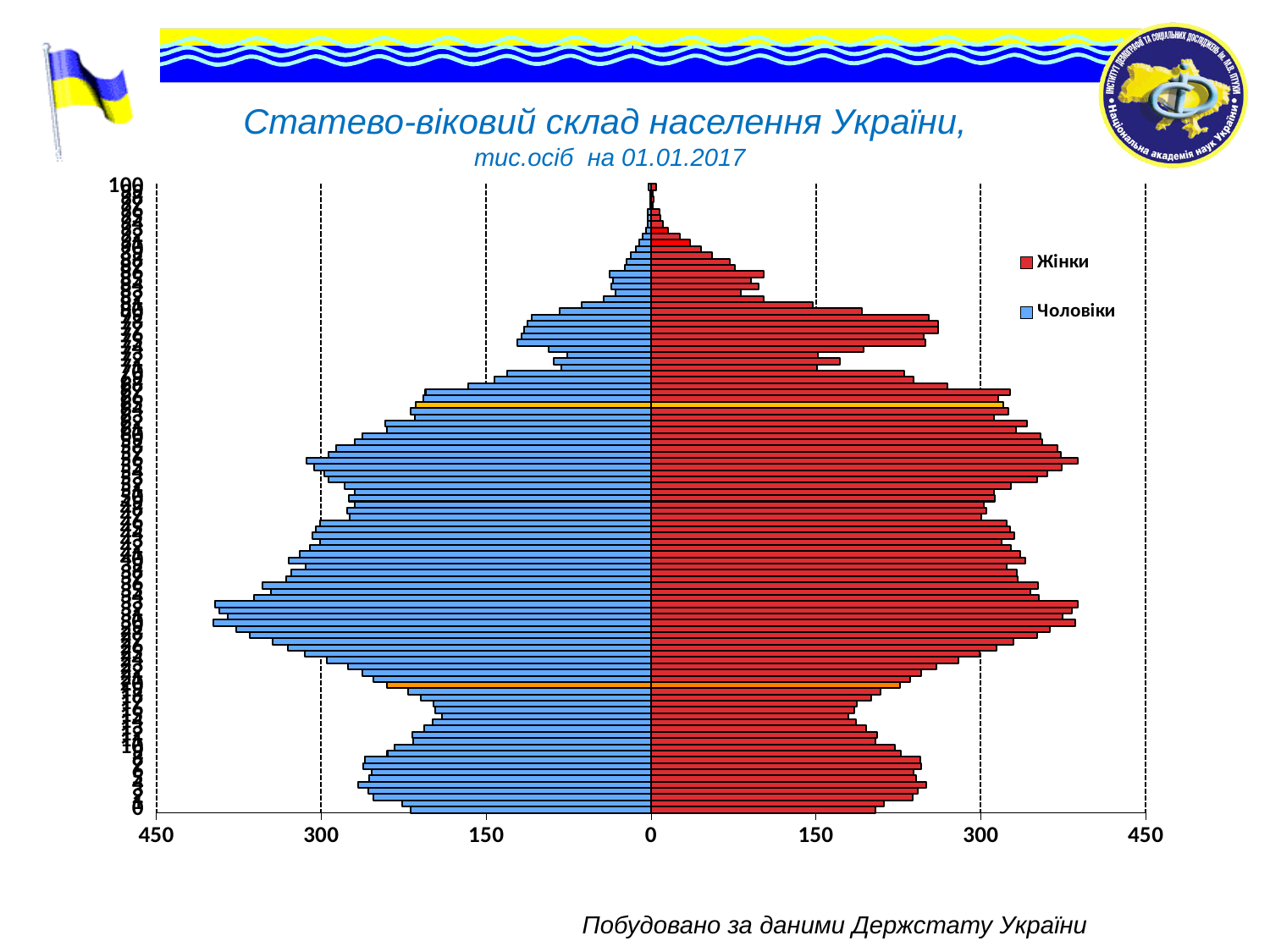
What kind of chart is shown on the slide? bar chart Is the longest red (Жінки) bar greater or less than 300? greater What is the largest value shown on the horizontal axis? 450 Is the bottom (age 0) bar for Чоловіки greater or less than 150? greater Which series is shown in red according to the legend? Жінки Is the longest blue (Чоловіки) bar greater or less than 300? greater How many series does the legend list? 2 Which series is shown in blue according to the legend? Чоловіки